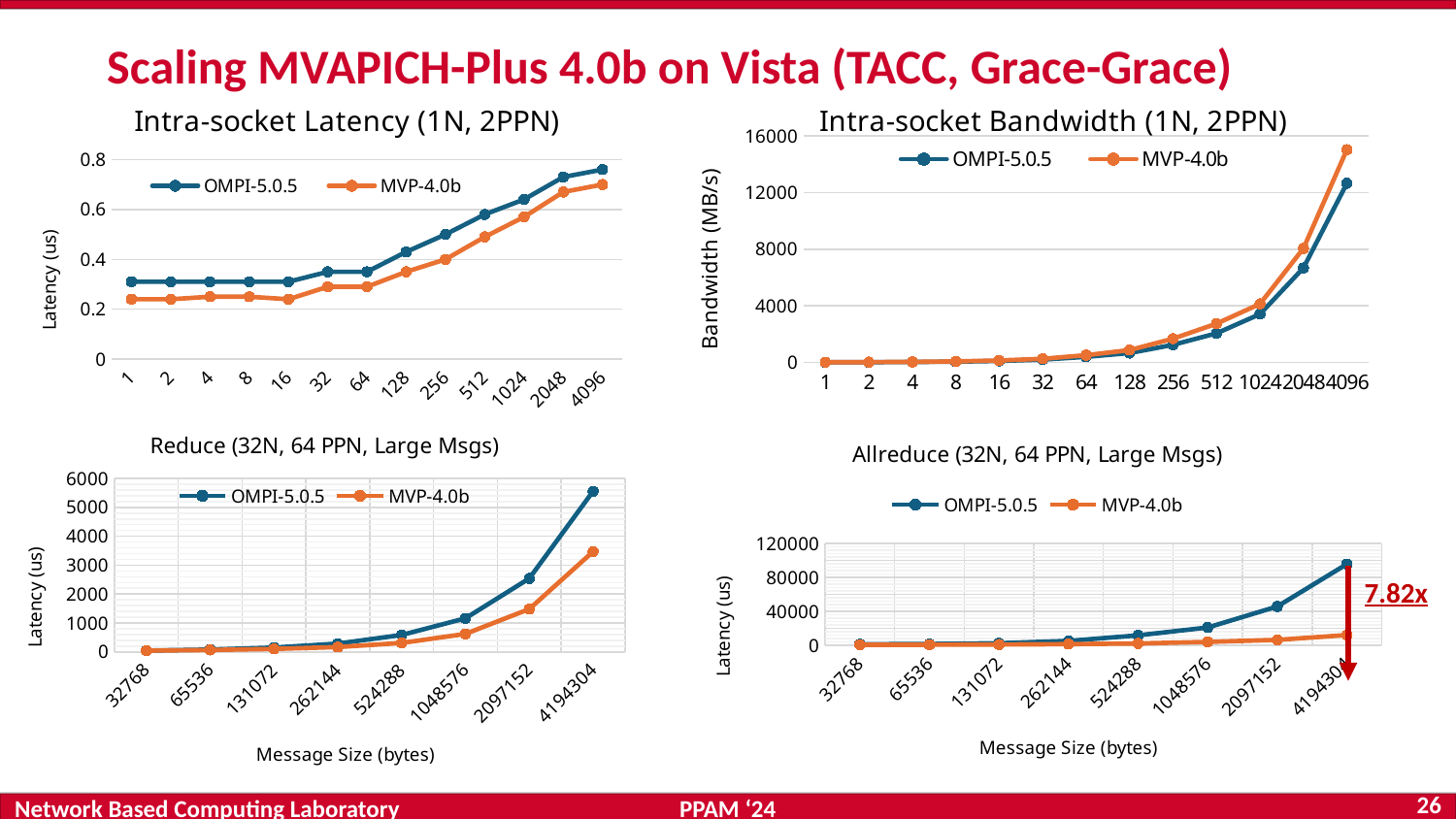
How many message sizes are plotted along the x axis of the Reduce (32N, 64 PPN, Large Msgs) chart? 8 What kind of chart is the Intra-socket Latency (1N, 2PPN) chart? line chart In the Intra-socket Latency (1N, 2PPN) chart, is the MVP-4.0b value at message size 1 greater or less than 0.4? less In the Intra-socket Bandwidth (1N, 2PPN) chart, is the MVP-4.0b value at message size 4096 greater or less than 12000? greater In the Intra-socket Latency (1N, 2PPN) chart, is the OMPI-5.0.5 value at message size 4096 greater or less than 0.6? greater In the Intra-socket Bandwidth (1N, 2PPN) chart, which series has the higher bandwidth at message size 4096? MVP-4.0b In the Reduce (32N, 64 PPN, Large Msgs) chart, which series has the higher latency at message size 4194304? OMPI-5.0.5 How many message sizes are plotted along the x axis of the Intra-socket Latency (1N, 2PPN) chart? 13 What speedup factor is annotated next to the Allreduce (32N, 64 PPN, Large Msgs) chart? 7.82x How many series does the legend of the Intra-socket Bandwidth (1N, 2PPN) chart list? 2